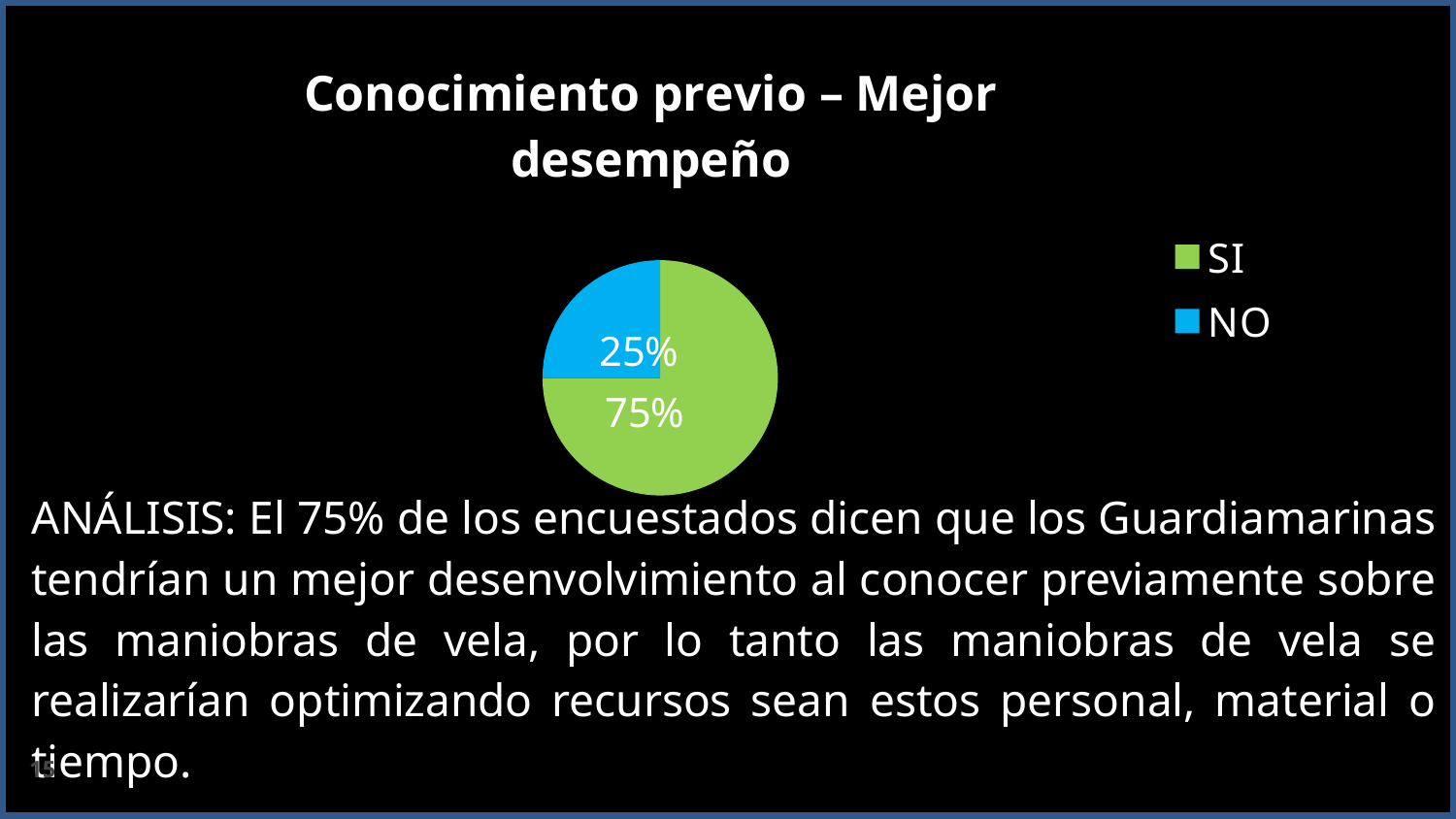
What is the difference in percentage points between the SI and NO slices? 50 What percentage of the pie does the NO slice represent? 25% Which category has the smallest slice of the pie? NO How many slices does the pie chart have? 2 What colour is the SI slice? green Is the value for NO greater or less than 50%? less Which category has the largest slice of the pie? SI Which slice is larger, SI or NO? SI How many categories does the legend list? 2 What percentage of the pie does the SI slice represent? 75% What kind of chart is shown on the slide? pie chart What is the title of the chart? Conocimiento previo – Mejor desempeño